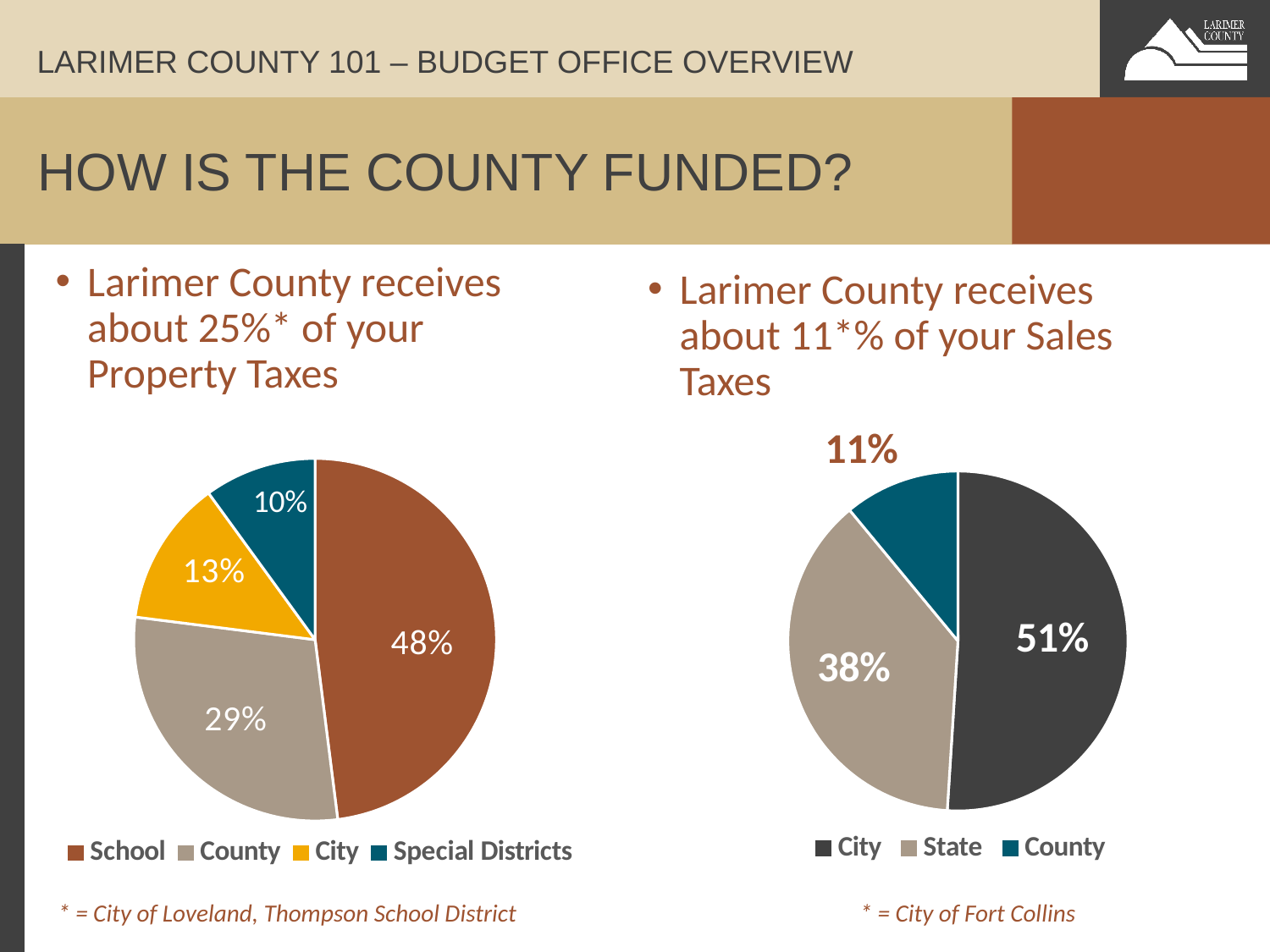
In the right pie chart, what share does State have? 38% In the left pie chart, what share does School have? 48% In the right pie chart, what is the difference between the City and State shares? 13% In the right pie chart, which category has the largest slice? City How many categories does the right pie chart's legend list? 3 In the left pie chart, what is the difference between the School and County shares? 19% In the left pie chart, what share does County have? 29% In the left pie chart, which is larger, City or Special Districts? City In the left pie chart, which category has the largest slice? School In the left pie chart, which category has the smallest slice? Special Districts What type of chart is the left chart? Pie chart In the right pie chart, what share does County have? 11%